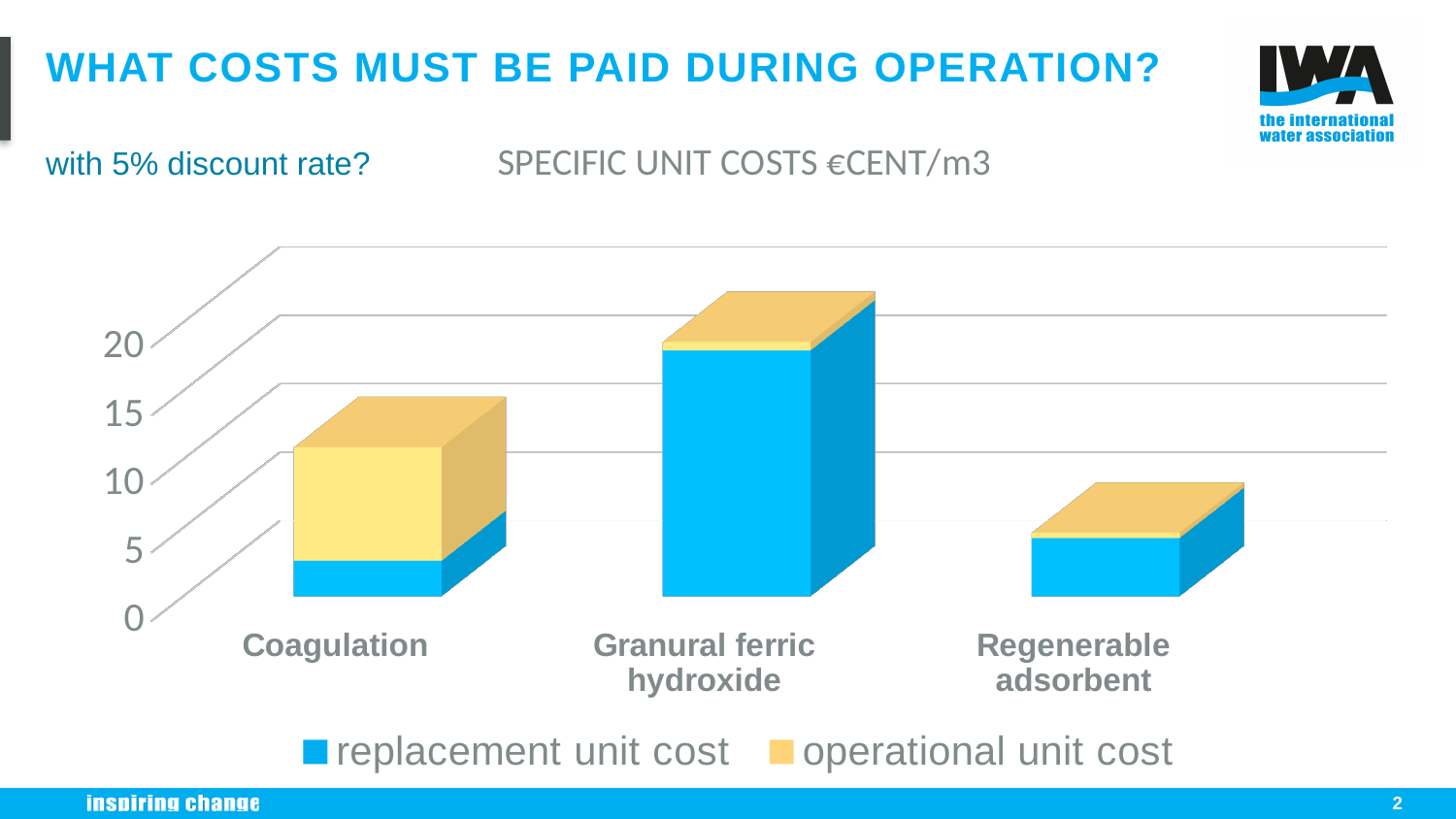
Which category has the lowest total specific unit cost? Regenerable adsorbent What are the two series named in the chart's legend? replacement unit cost and operational unit cost Which category has the highest operational unit cost? Coagulation Is the total specific unit cost for Granural ferric hydroxide greater or less than 15? greater Which category has the highest total specific unit cost? Granural ferric hydroxide Which category has the highest replacement unit cost? Granural ferric hydroxide Is the total specific unit cost for Regenerable adsorbent greater or less than 10? less How many series does the chart's legend list? 2 Which is larger: the replacement unit cost for Granural ferric hydroxide or for Coagulation? Granural ferric hydroxide How many categories are shown on the x axis of the chart? 3 What kind of chart is shown on the slide? Bar chart